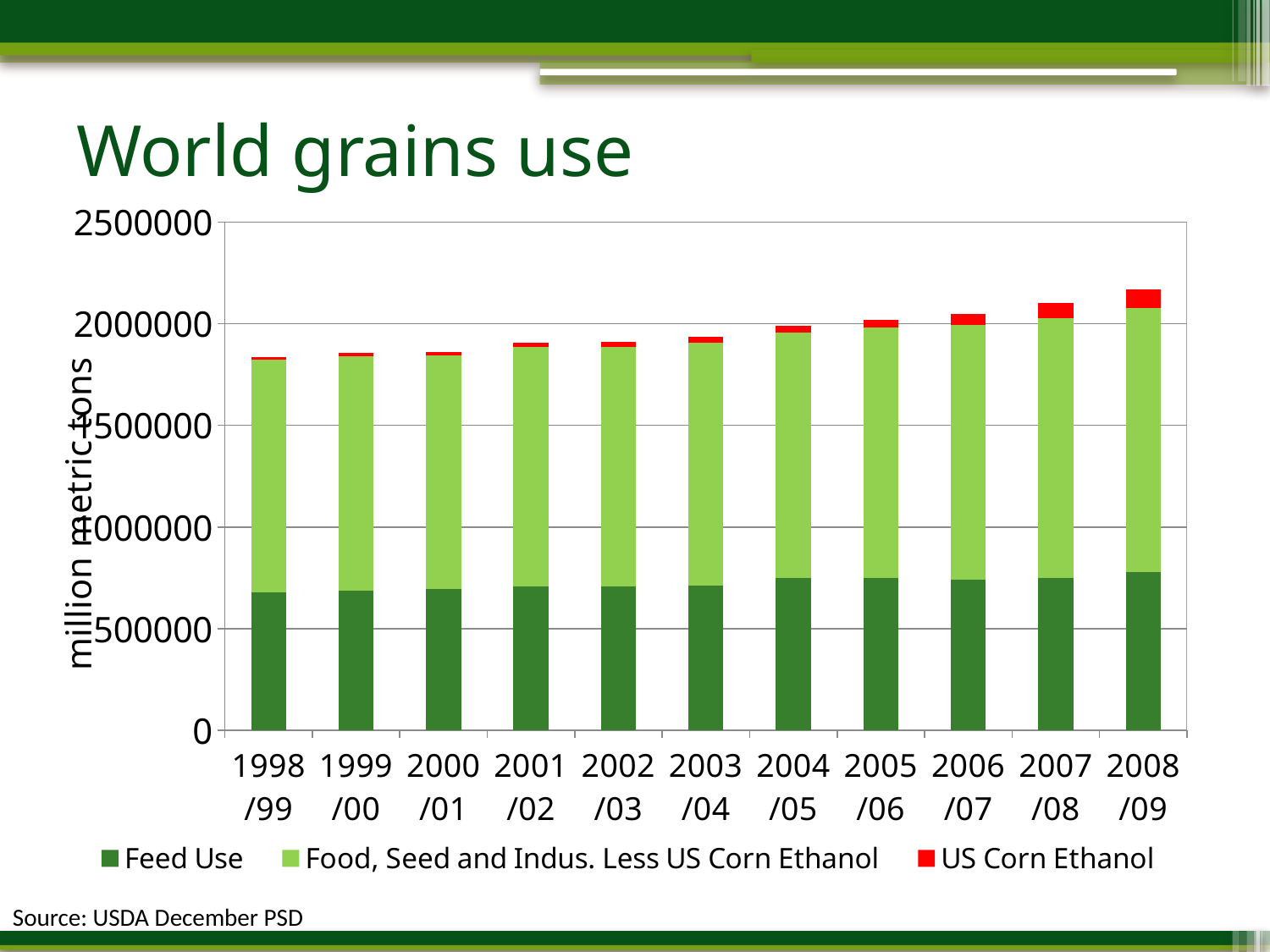
Which year has the tallest total bar? 2008/09 What kind of chart is shown on the slide? Stacked bar chart Is the Feed Use value for 2008/09 greater or less than 1000000? less What is the label on the vertical axis? million metric tons Do the total bar heights generally rise or fall from 1998/99 to 2008/09? Rise Is the total bar for 1998/99 greater or less than 2000000? less What is the title of the chart? World grains use Which year has the larger US Corn Ethanol segment, 1998/99 or 2008/09? 2008/09 How many years (categories) are shown on the x axis? 11 Which year has the shortest total bar? 1998/99 Is the total bar for 2008/09 greater or less than 2000000? greater How many series does the legend list? 3